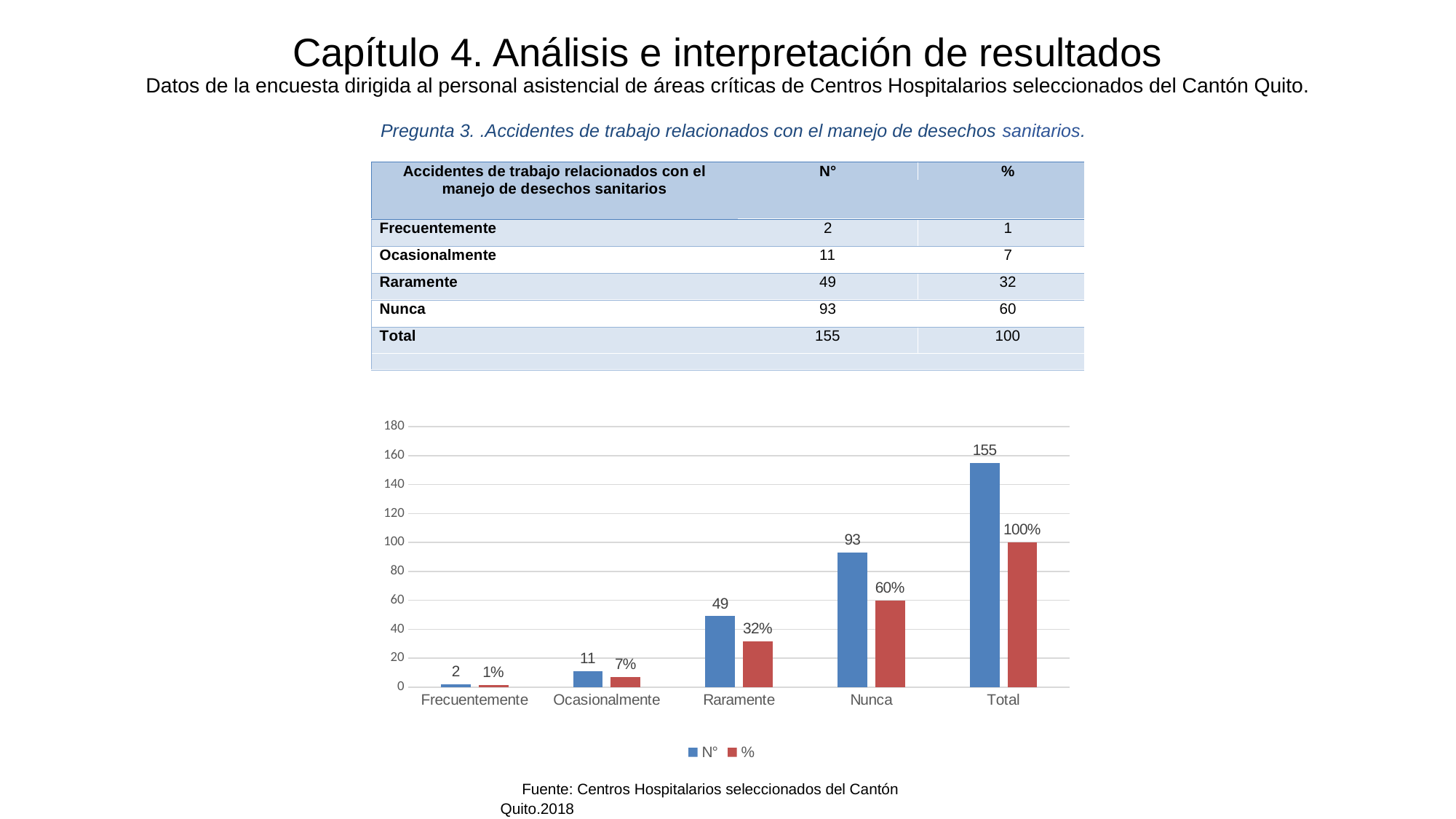
How many series does the chart legend list? 2 Which category has the lowest N° value in the chart? Frecuentemente How many categories are shown on the x axis of the chart? 5 What is the % value shown for Raramente in the chart? 32% What is the N° value for Ocasionalmente in the chart? 11 What is the N° value for Nunca in the chart? 93 Is the N° value for Total greater or less than 140 in the chart? greater Excluding Total, which category has the highest N° value in the chart? Nunca What kind of chart is shown on the slide? Bar chart What are the two series names listed in the chart legend? N° and % What is the difference between the N° values for Nunca and Raramente in the chart? 44 Which is larger in the chart: the N° value for Ocasionalmente or the N° value for Raramente? Raramente